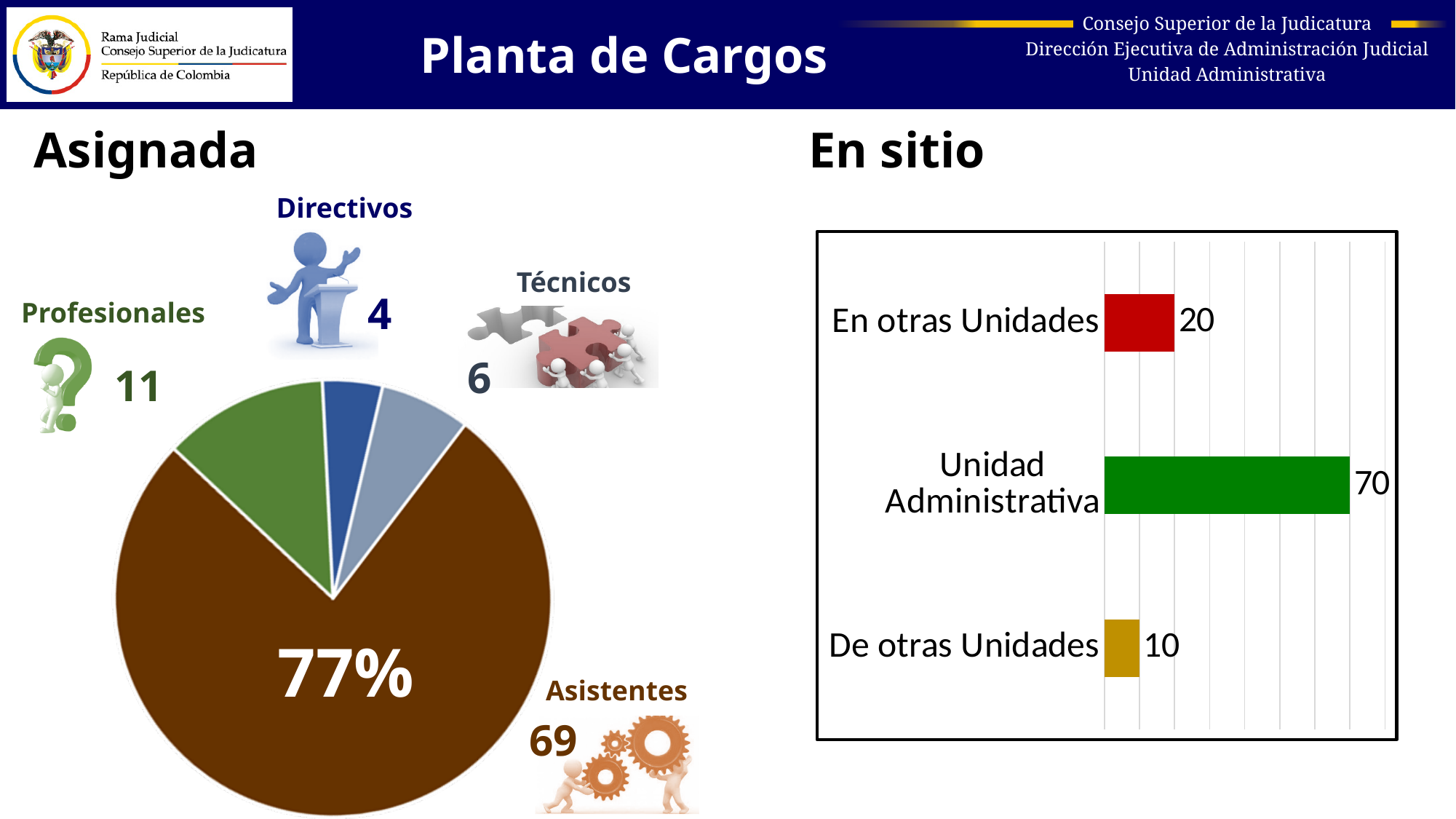
In the 'Asignada' pie chart, which category has the smallest slice? Directivos In the 'Asignada' pie chart, which is larger, Técnicos or Profesionales? Profesionales In the 'En sitio' bar chart, what is the difference between Unidad Administrativa and En otras Unidades? 50 In the 'Asignada' pie chart, what share of the pie do Asistentes represent? 77% What kind of chart is the 'En sitio' chart? Bar chart In the 'En sitio' bar chart, what is the value for Unidad Administrativa? 70 In the 'En sitio' bar chart, which category has the lowest value? De otras Unidades In the 'Asignada' pie chart, how many Asistentes are there? 69 In the 'En sitio' bar chart, which category has the highest value? Unidad Administrativa In the 'Asignada' pie chart, how many Profesionales are there? 11 In the 'En sitio' bar chart, how many categories are shown? 3 In the 'En sitio' bar chart, what is the value for De otras Unidades? 10